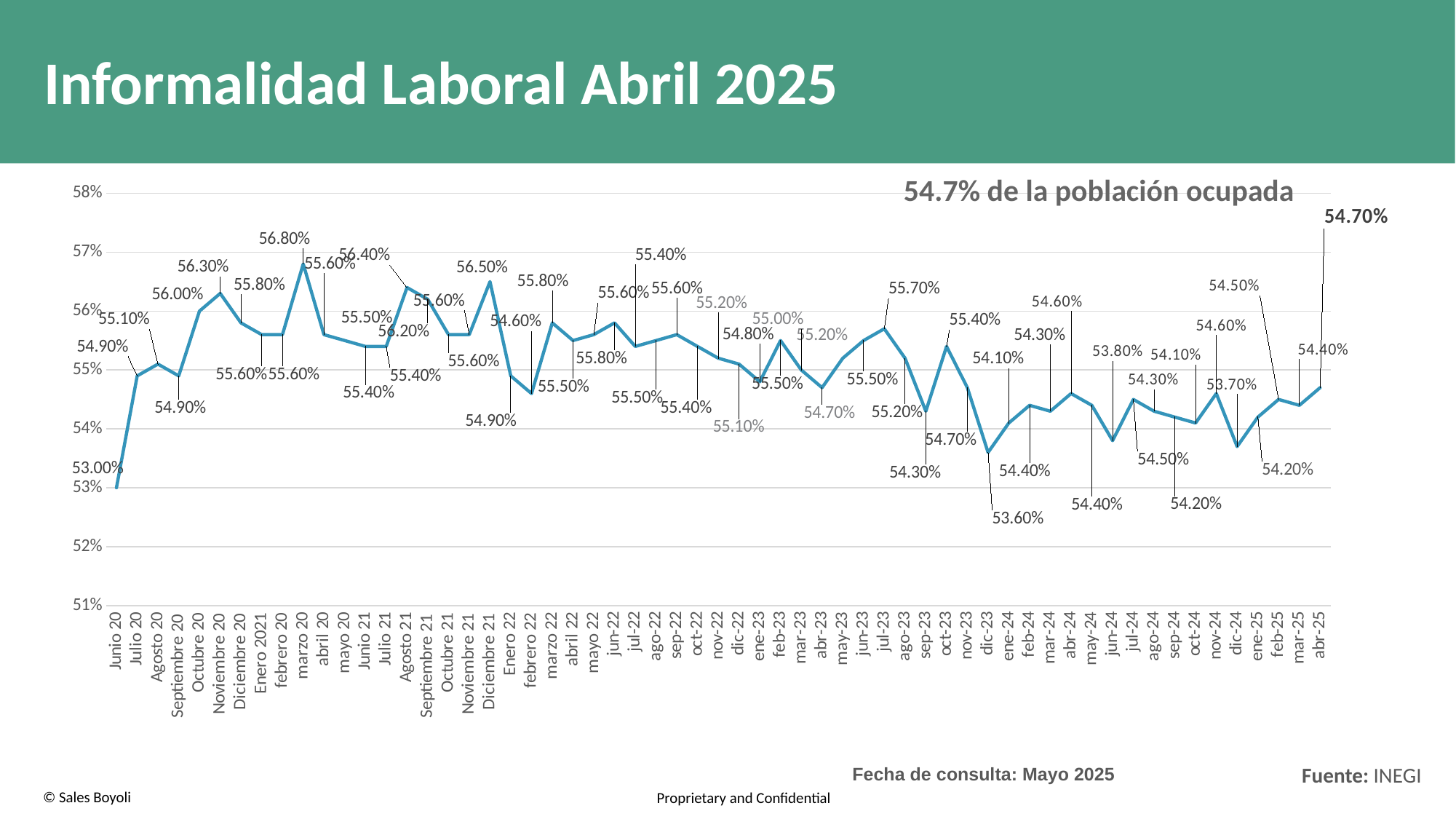
Is the value for dic-23 greater or less than 54%? less Which month has the lowest value on the chart? Junio 20 (53.00%) What is the difference between the value for abr-25 and the value for Junio 20? 1.70 percentage points What is the value for abr-25? 54.70% What is the value for dic-23? 53.60% Which month has the highest value on the chart? marzo 20 (56.80%) What annotation text is shown in the upper right of the chart? 54.7% de la población ocupada What is the value for Junio 20? 53.00% What kind of chart is shown on the slide? Line chart Does the value rise or fall from Junio 20 to Julio 20? Rise Which is larger, the value for Junio 20 or the value for abr-25? abr-25 What is the value for Noviembre 20? 56.30%